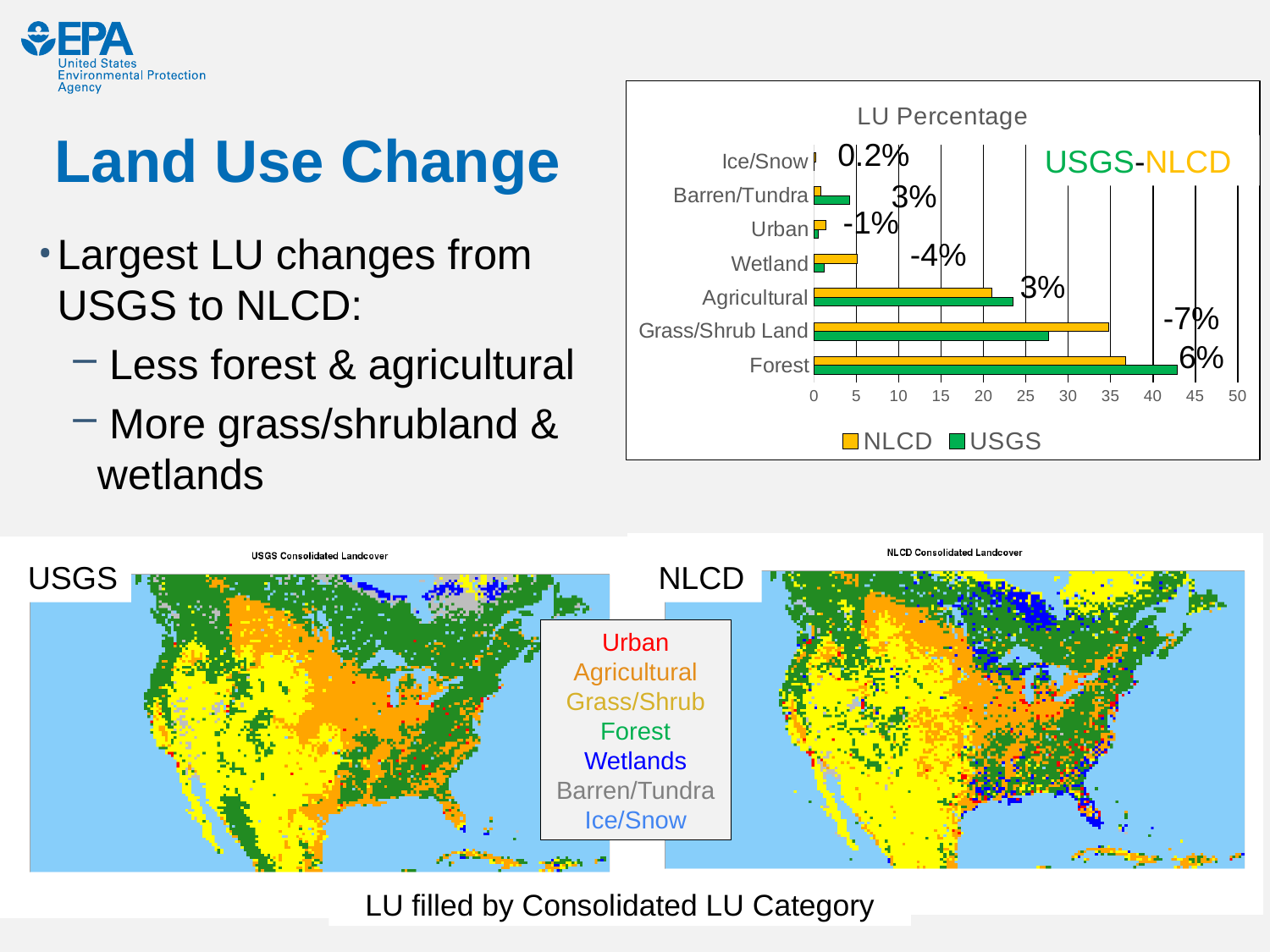
What kind of chart is the "LU Percentage" chart? bar chart In the "LU Percentage" chart, what USGS-NLCD difference is labelled for Grass/Shrub Land? -7% In the "LU Percentage" chart, which category has the highest USGS value? Forest In the "LU Percentage" chart, which is larger for Grass/Shrub Land, the NLCD value or the USGS value? NLCD In the "LU Percentage" chart, what USGS-NLCD difference is labelled for Wetland? -4% In the "LU Percentage" chart, which category has the highest NLCD value? Forest In the "LU Percentage" chart, what USGS-NLCD difference is labelled for Forest? 6% In the "LU Percentage" chart, which category has the lowest NLCD value? Ice/Snow How many series does the legend of the "LU Percentage" chart list? 2 In the "LU Percentage" chart, is the USGS value for Forest greater or less than 40? greater How many land use categories are shown on the "LU Percentage" chart? 7 In the "LU Percentage" chart, which series is shown in green? USGS